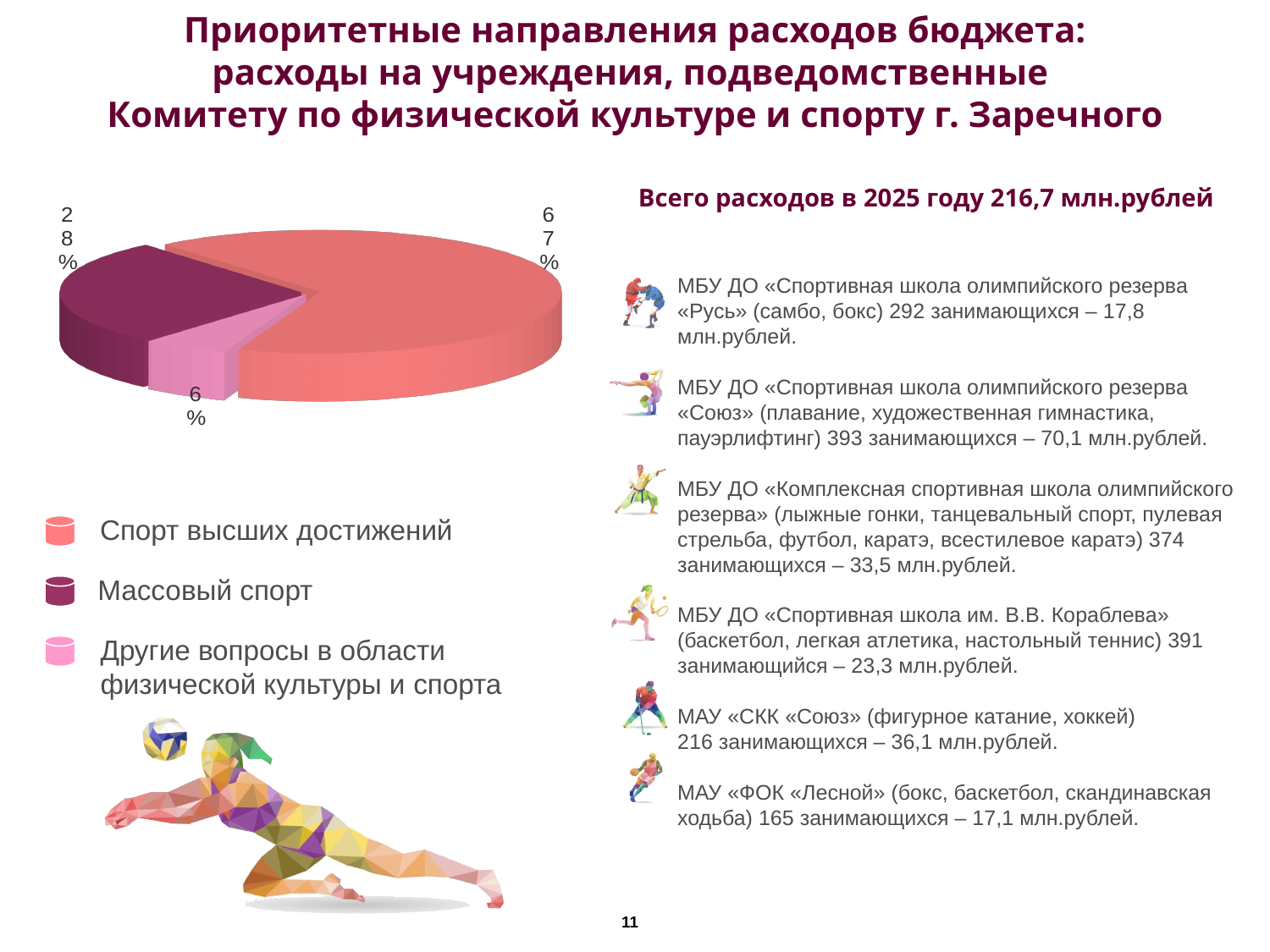
Which category has the smallest slice of the pie? Другие вопросы в области физической культуры и спорта Which is larger: the slice for «Массовый спорт» or the slice for «Другие вопросы в области физической культуры и спорта»? Массовый спорт How many slices does the pie chart have? 3 What share of the pie does «Массовый спорт» have? 28% How many entries does the legend of the pie chart list? 3 What kind of chart is shown on the slide? Pie chart Which category has the largest slice of the pie? Спорт высших достижений What is the difference in percentage points between «Массовый спорт» and «Другие вопросы в области физической культуры и спорта»? 22 What colour is the slice for «Массовый спорт» in the pie chart? Dark magenta What is the difference in percentage points between «Спорт высших достижений» and «Массовый спорт»? 39 What share of the pie does «Другие вопросы в области физической культуры и спорта» have? 6% What share of the pie does «Спорт высших достижений» have? 67%